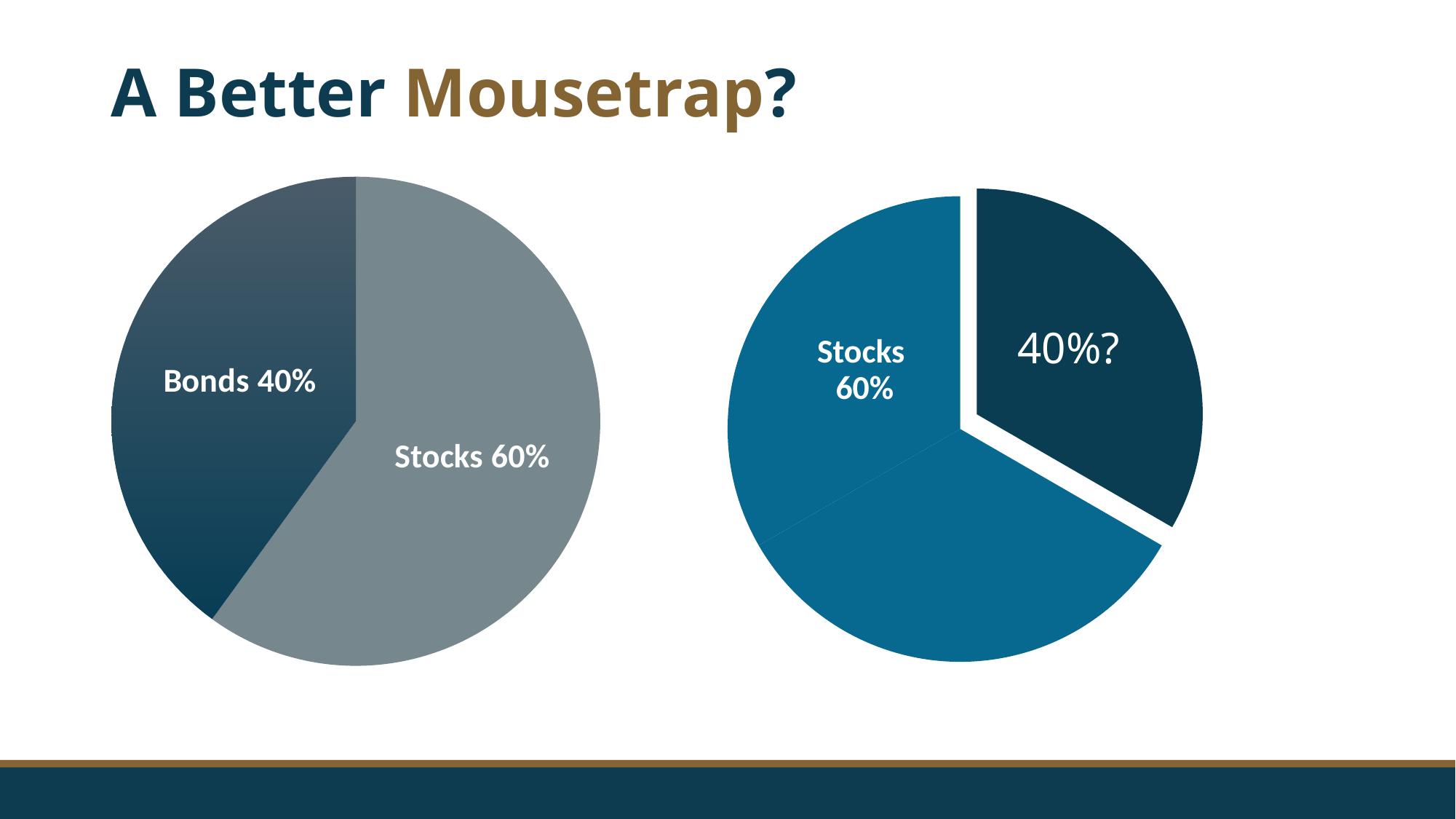
On the left pie chart, what share is labelled for Stocks? 60% What is the title of the slide? A Better Mousetrap? On the left pie chart, what share is labelled for Bonds? 40% On the right pie chart, which slice is pulled out from the rest of the pie? The 40%? slice On the left pie chart, what is the difference between the Stocks share and the Bonds share? 20% What kind of chart is shown on the right of the slide? Pie chart On the left pie chart, how many slices are there? 2 On the left pie chart, which slice is larger, Bonds or Stocks? Stocks On the right pie chart, what share is labelled for Stocks? 60% On the right pie chart, what label is shown on the exploded dark slice? 40%? What kind of chart is shown on the left of the slide? Pie chart On the right pie chart, how many slices are there? 2